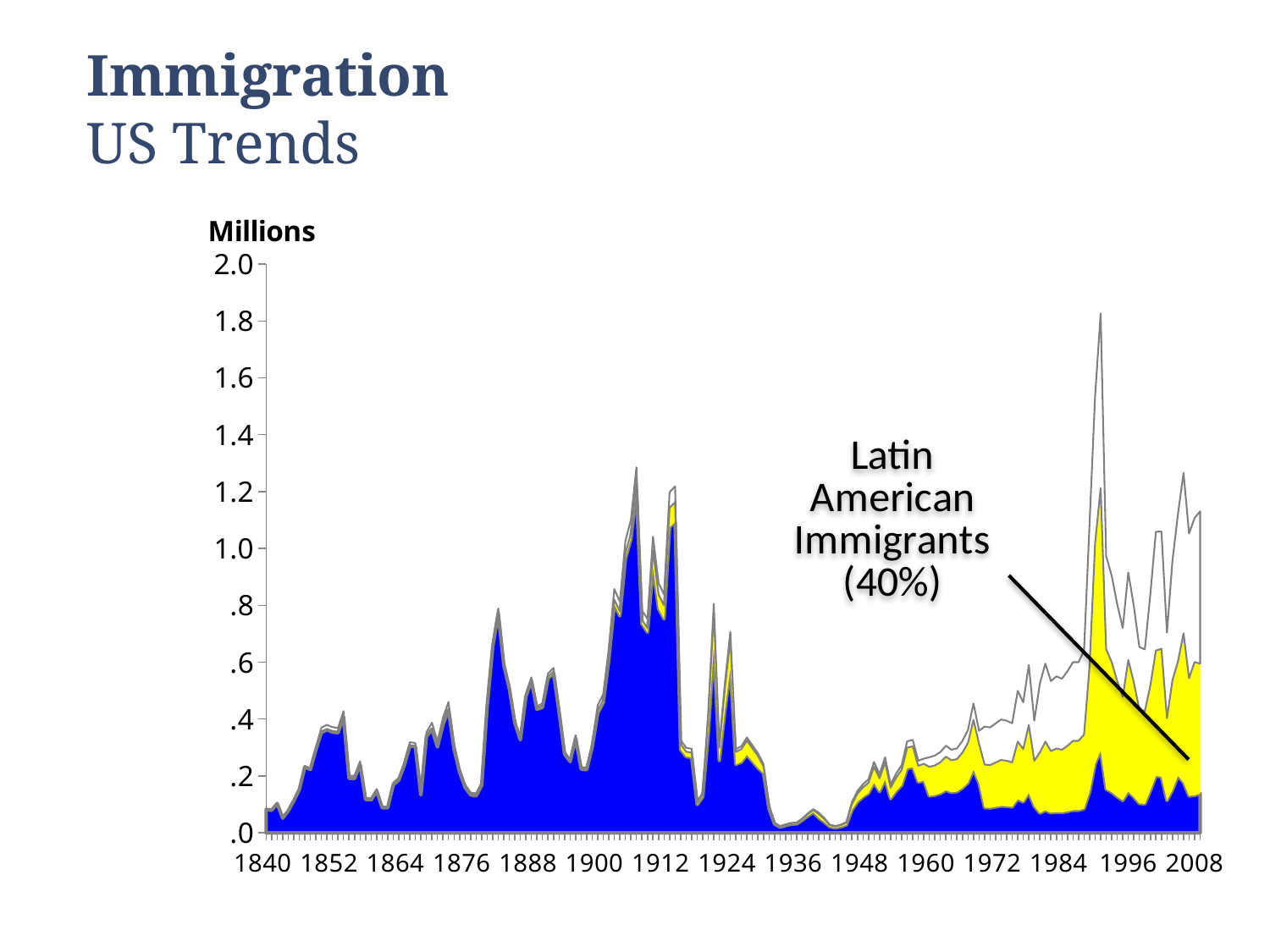
Which is higher: the immigration peak around 1854 or the peak around 1882? The peak around 1882 Does total immigration generally rise or fall between 1936 and 2008? Rise Is the highest peak on the chart located before or after 1984 on the x-axis? after Is the highest peak of total immigration on the chart greater or less than 1.6 million? greater What percentage is given in the label for Latin American Immigrants? 40% Is the peak of immigration around 1882 greater or less than .6 million? greater Is the peak of immigration around 1907 greater or less than 1.0 million? greater Which is higher: the immigration peak around 1907 or the peak between 1984 and 1996? The peak between 1984 and 1996 What kind of chart is shown on the slide? Area chart How many year labels are shown on the x-axis? 15 What unit is the y-axis measured in? Millions